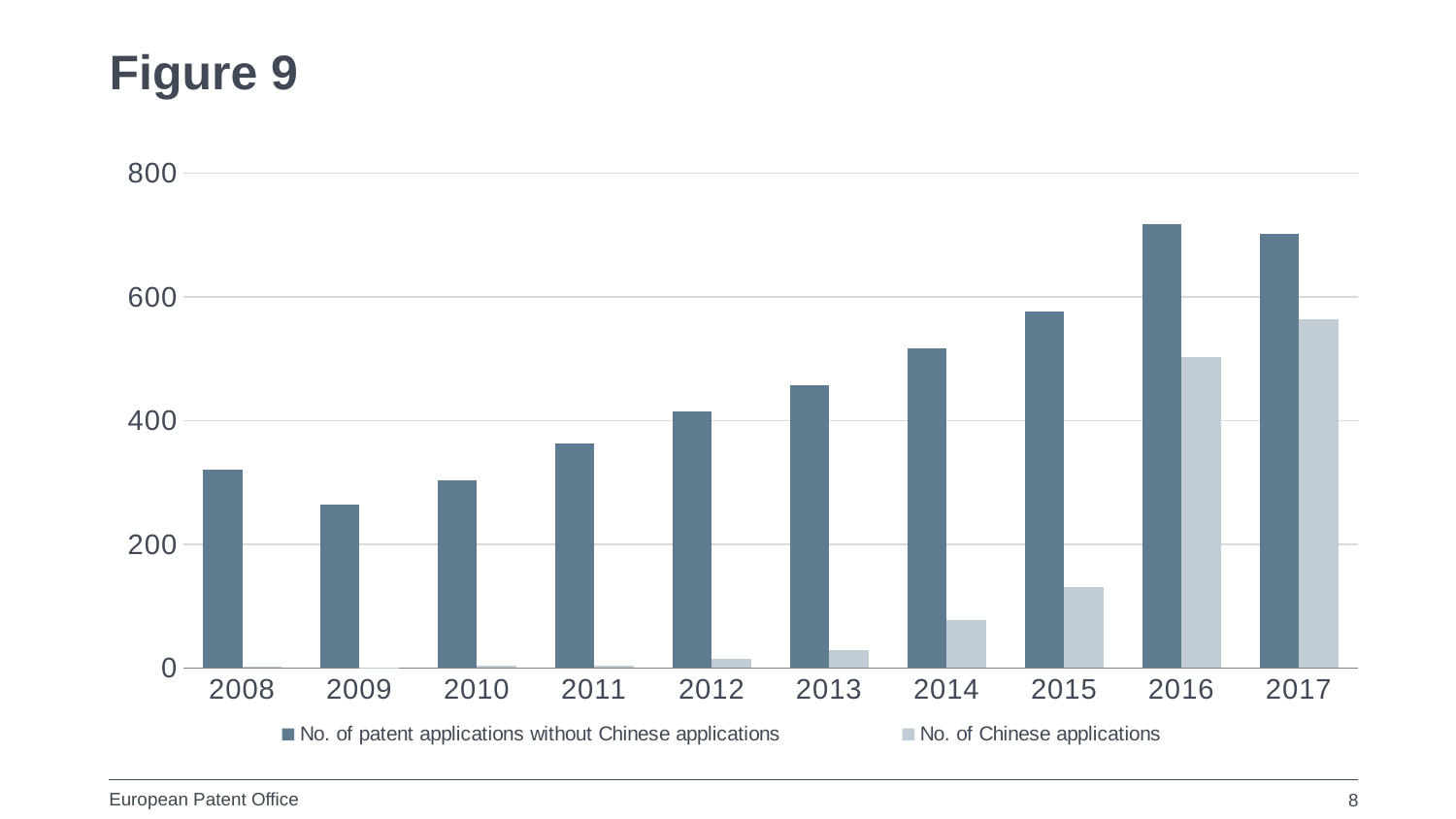
Is the number of patent applications without Chinese applications in 2008 greater or less than 200? greater Is the number of patent applications without Chinese applications in 2016 greater or less than 600? greater Which year has the highest number of Chinese applications? 2017 How many series does the legend list? 2 In 2017, which is larger: the number of patent applications without Chinese applications or the number of Chinese applications? No. of patent applications without Chinese applications Is the number of Chinese applications in 2015 greater or less than 200? less What kind of chart is shown on the slide? bar chart Which year has the highest number of patent applications without Chinese applications? 2016 How many years are shown on the x axis? 10 Which year has the lowest number of patent applications without Chinese applications? 2009 Do the numbers of Chinese applications generally rise or fall from 2008 to 2017? rise